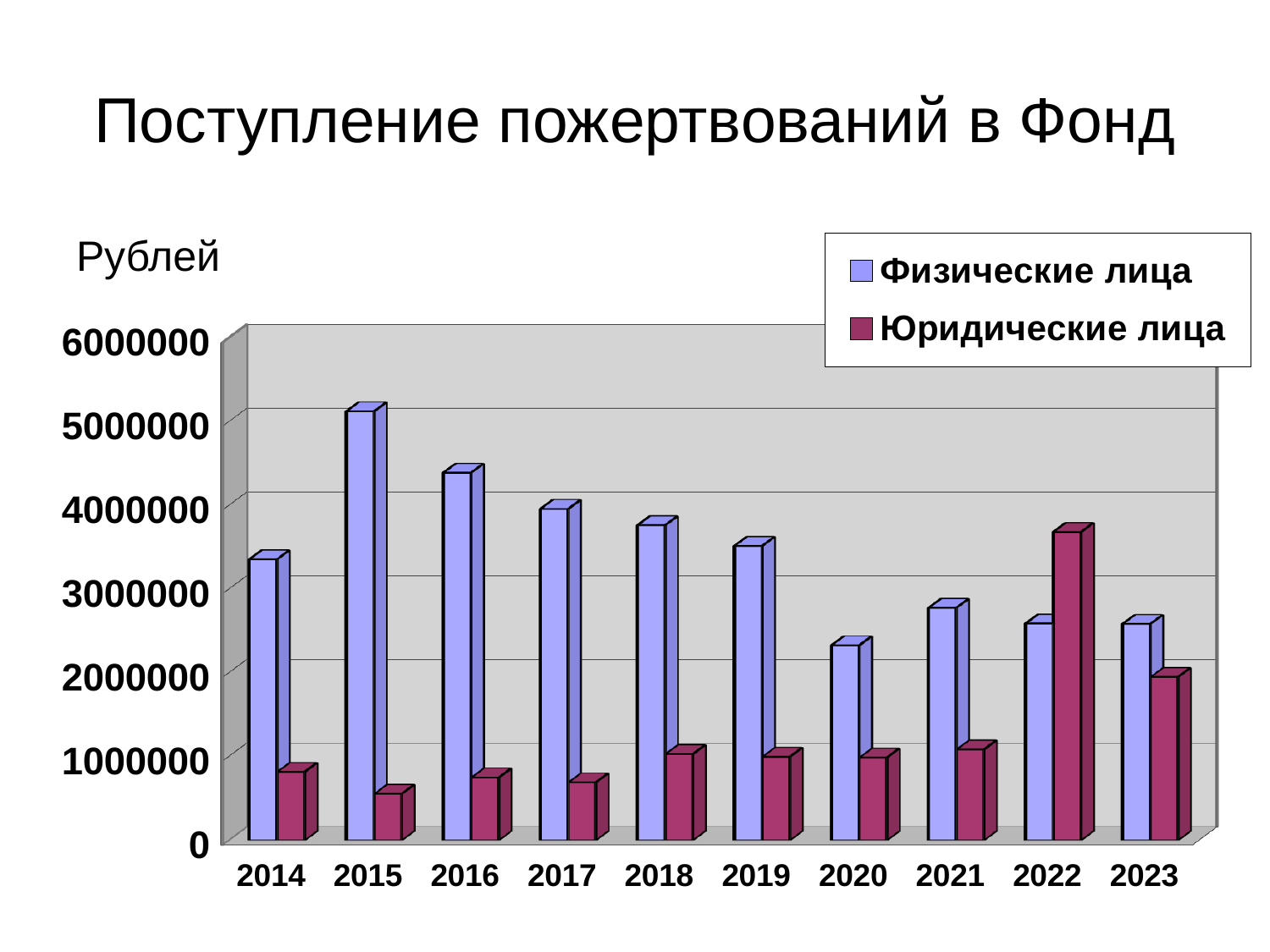
Is the value for Физические лица in 2015 greater or less than 5000000? greater Is the value for Юридические лица in 2022 greater or less than 3000000? greater How many years are shown on the x axis? 10 In 2022, which series has the larger value, Физические лица or Юридические лица? Юридические лица In which year is the value for Юридические лица lowest? 2015 In which year is the value for Физические лица lowest? 2020 In which year is the value for Физические лица highest? 2015 In which year is the value for Юридические лица highest? 2022 How many series does the legend list? 2 What kind of chart is shown on the slide? bar chart Do the values for Физические лица rise or fall from 2015 to 2020? fall Is the value for Юридические лица in 2015 greater or less than 1000000? less